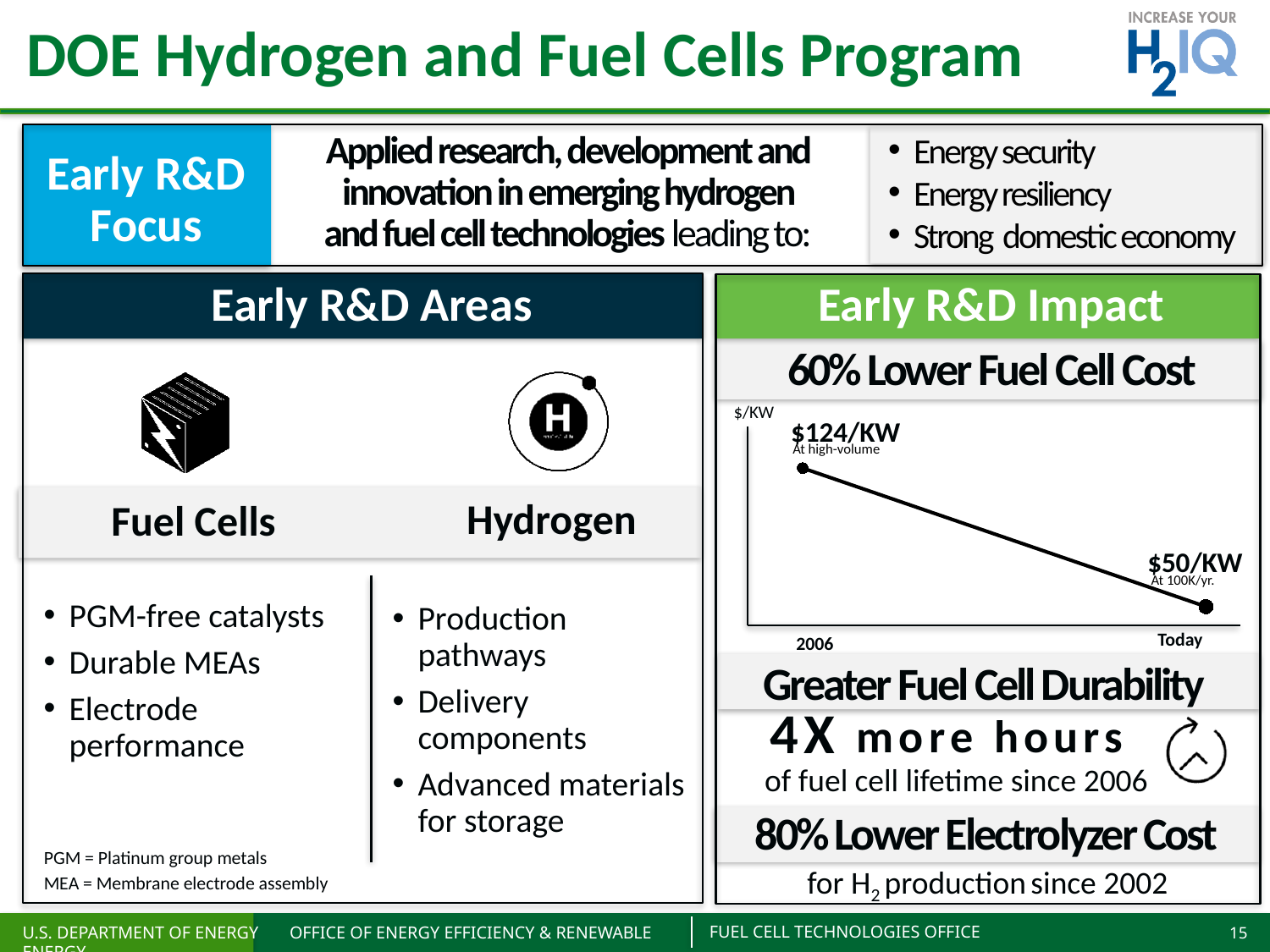
What is the fuel cell cost shown for 2006 on the chart? $124/KW What kind of chart is used to show the fuel cell cost? line chart Which point on the chart has the lower fuel cell cost, 2006 or Today? Today What unit is shown on the vertical axis of the fuel cell cost chart? $/KW What is the heading above the fuel cell cost chart? 60% Lower Fuel Cell Cost By how much did the fuel cell cost fall from 2006 to Today according to the chart? $74/KW Does the fuel cell cost rise or fall from 2006 to Today on the chart? fall Is the fuel cell cost for 2006 larger or smaller than the cost for Today? larger What is the fuel cell cost shown for Today on the chart? $50/KW How many data points are plotted on the fuel cell cost chart? 2 What are the two labels on the horizontal axis of the fuel cell cost chart? 2006 and Today Which point on the chart has the higher fuel cell cost, 2006 or Today? 2006